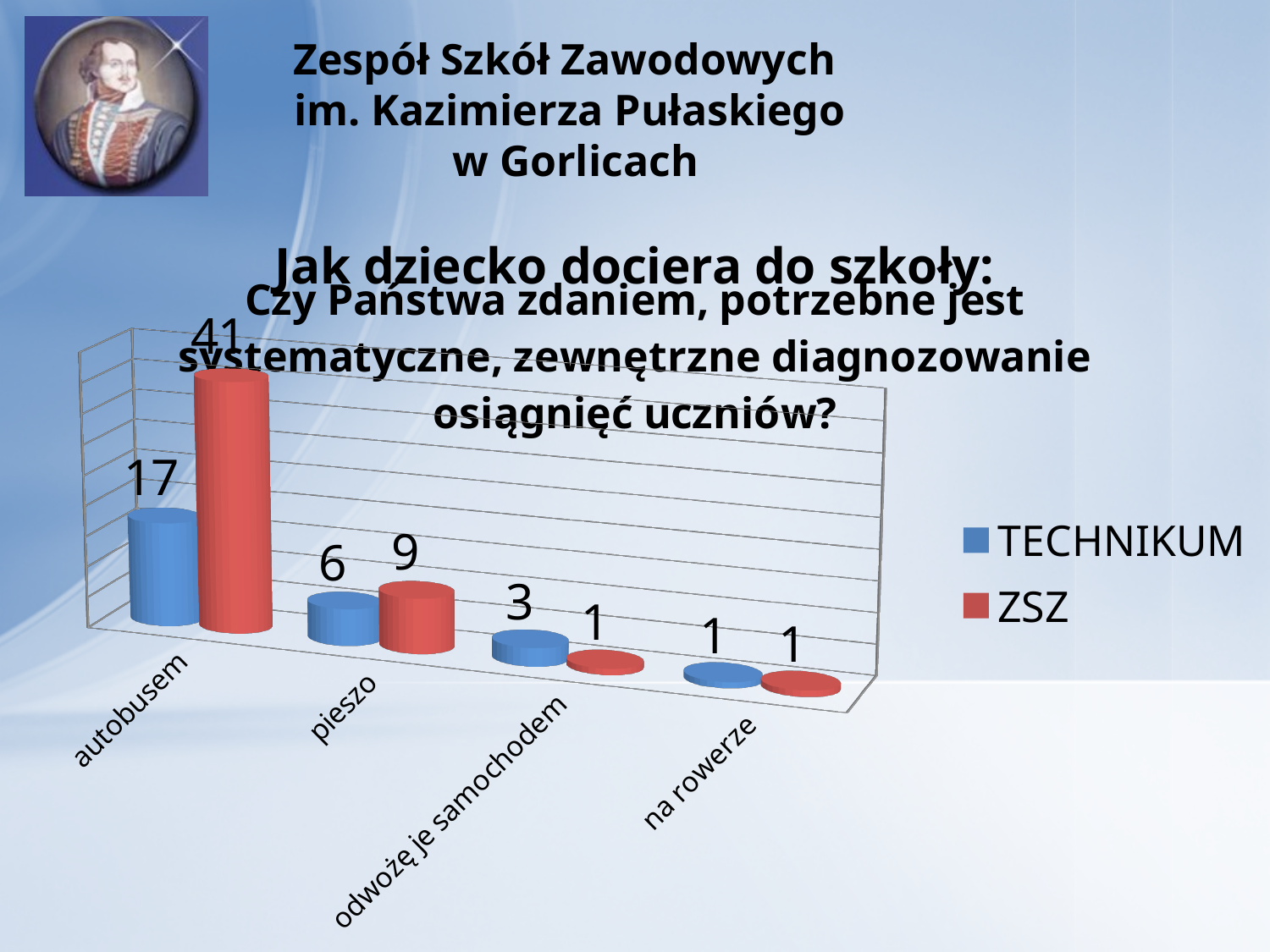
How many categories are shown on the x axis? 4 Which category has the lowest TECHNIKUM value? na rowerze What kind of chart is shown on the slide? bar chart Which category has the highest ZSZ value? autobusem What is the TECHNIKUM value for "odwożę je samochodem"? 3 For "pieszo", which series has the larger value, TECHNIKUM or ZSZ? ZSZ What is the ZSZ value for "autobusem"? 41 What is the ZSZ value for "pieszo"? 9 What is the difference between the ZSZ and TECHNIKUM values for "autobusem"? 24 What is the TECHNIKUM value for "autobusem"? 17 How many series does the legend list? 2 Which colour represents the ZSZ series? red